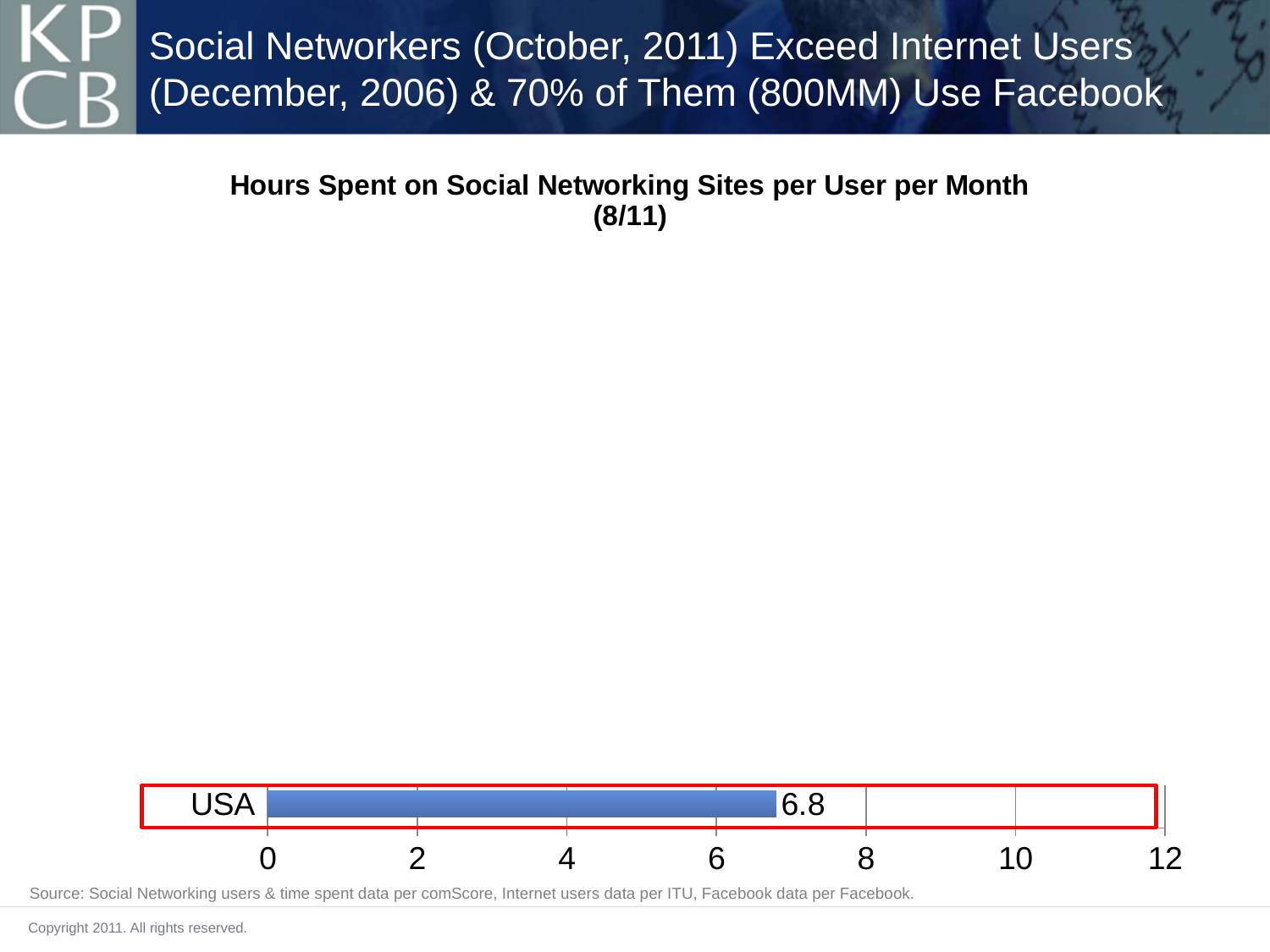
What kind of chart is shown on the slide? bar chart Is the value for USA greater or less than 8? less What is the value for USA in the chart? 6.8 Is the value for USA greater or less than 6? greater How many categories are plotted in the chart? 1 What is the title of the chart? Hours Spent on Social Networking Sites per User per Month (8/11) What is the maximum value shown on the chart's x axis? 12